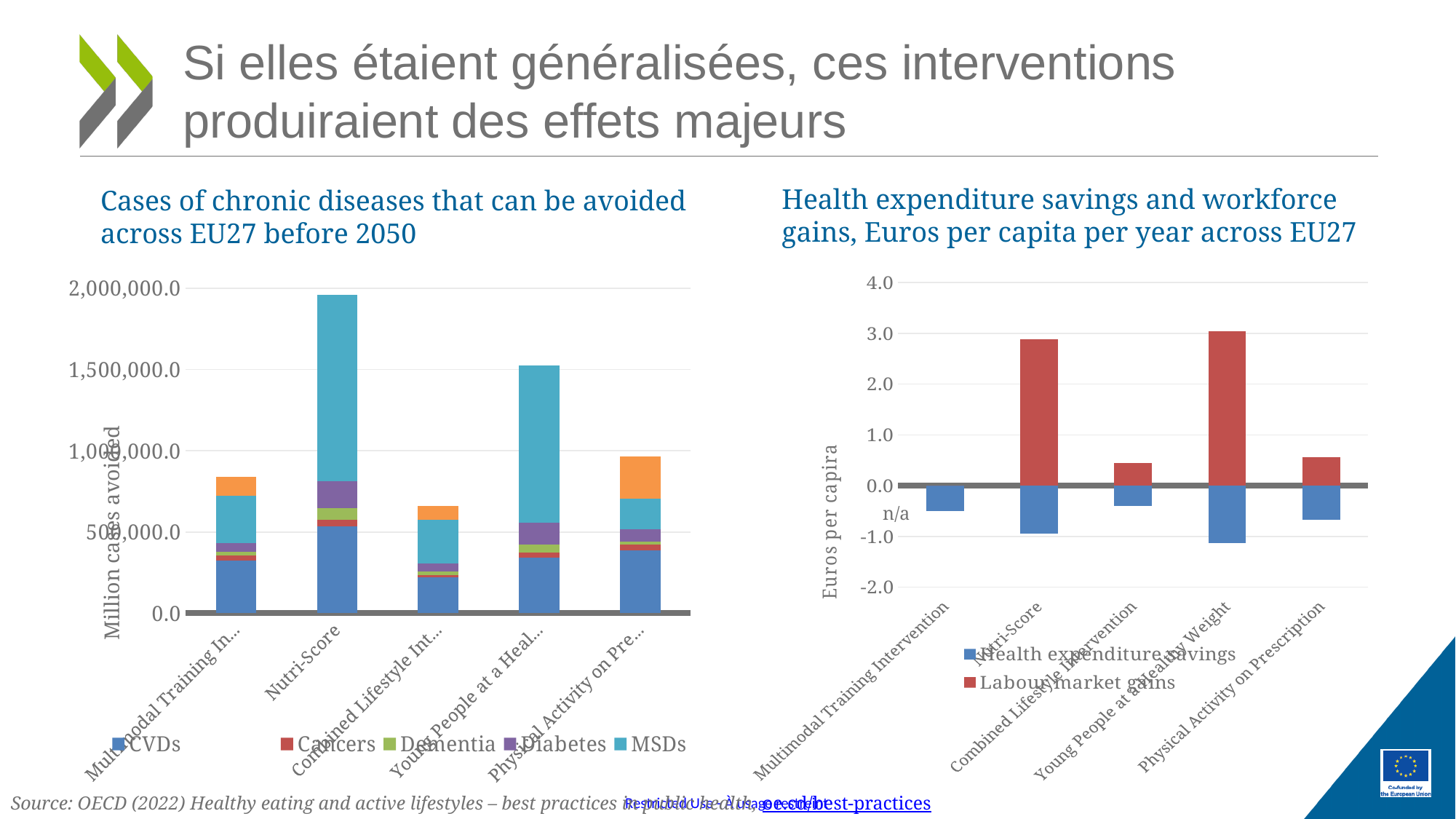
In the left chart, 'Cases of chronic diseases that can be avoided across EU27 before 2050', is the total for Combined Lifestyle Int... greater or less than 1,000,000.0? less In the left chart, 'Cases of chronic diseases that can be avoided across EU27 before 2050', how many series does the legend list? 5 In the right chart, 'Health expenditure savings and workforce gains, Euros per capita per year across EU27', which has larger Labour market gains: Nutri-Score or Combined Lifestyle Intervention? Nutri-Score In the left chart, 'Cases of chronic diseases that can be avoided across EU27 before 2050', which intervention has the shortest stacked bar? Combined Lifestyle Int... In the left chart, 'Cases of chronic diseases that can be avoided across EU27 before 2050', which intervention has the tallest stacked bar? Nutri-Score In the right chart, 'Health expenditure savings and workforce gains, Euros per capita per year across EU27', which intervention has Labour market gains marked as n/a? Multimodal Training Intervention In the right chart, 'Health expenditure savings and workforce gains, Euros per capita per year across EU27', is the Labour market gains value for Nutri-Score greater or less than 2.0? greater In the right chart, 'Health expenditure savings and workforce gains, Euros per capita per year across EU27', how many series does the legend list? 2 In the left chart, 'Cases of chronic diseases that can be avoided across EU27 before 2050', is the total for Nutri-Score greater or less than 1,500,000.0? greater What kind of chart is the left chart, 'Cases of chronic diseases that can be avoided across EU27 before 2050'? Stacked bar chart In the left chart, 'Cases of chronic diseases that can be avoided across EU27 before 2050', how many intervention categories are shown on the x axis? 5 In the right chart, 'Health expenditure savings and workforce gains, Euros per capita per year across EU27', how many interventions are shown on the x axis? 5